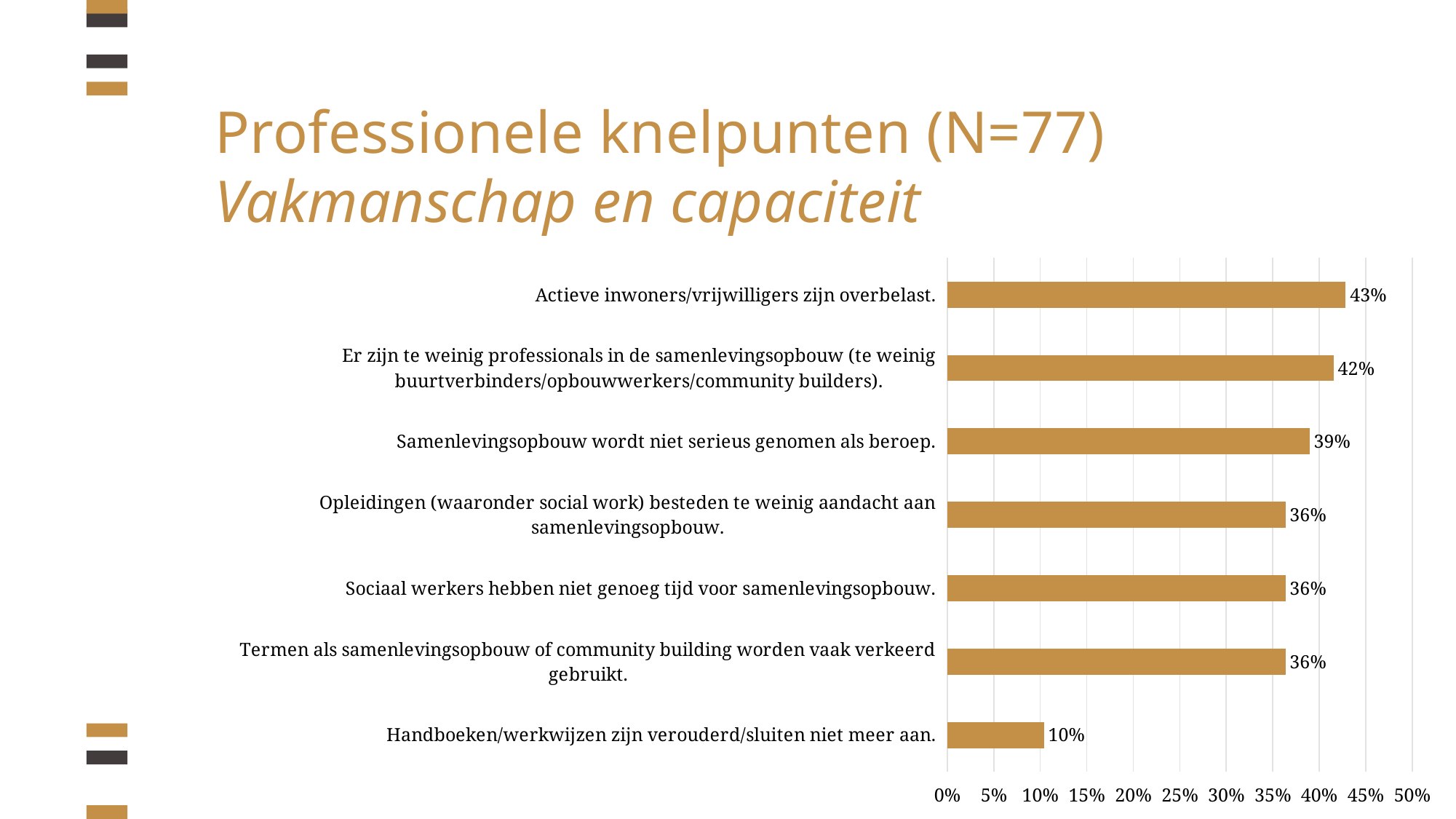
What percentage is shown for "Handboeken/werkwijzen zijn verouderd/sluiten niet meer aan."? 10% Which category has the lowest percentage? Handboeken/werkwijzen zijn verouderd/sluiten niet meer aan. What is the difference between the highest and lowest percentages in the chart? 33% Which is larger: the value for "Actieve inwoners/vrijwilligers zijn overbelast." or for "Samenlevingsopbouw wordt niet serieus genomen als beroep."? Actieve inwoners/vrijwilligers zijn overbelast. What percentage is shown for "Actieve inwoners/vrijwilligers zijn overbelast."? 43% How many categories share the value 36%? 3 How many categories are shown in the chart? 7 What is the difference between "Samenlevingsopbouw wordt niet serieus genomen als beroep." and "Sociaal werkers hebben niet genoeg tijd voor samenlevingsopbouw."? 3% What kind of chart is shown on the slide? Bar chart What percentage is shown for "Er zijn te weinig professionals in de samenlevingsopbouw"? 42% What percentage is shown for "Samenlevingsopbouw wordt niet serieus genomen als beroep."? 39% Which category has the highest percentage? Actieve inwoners/vrijwilligers zijn overbelast.